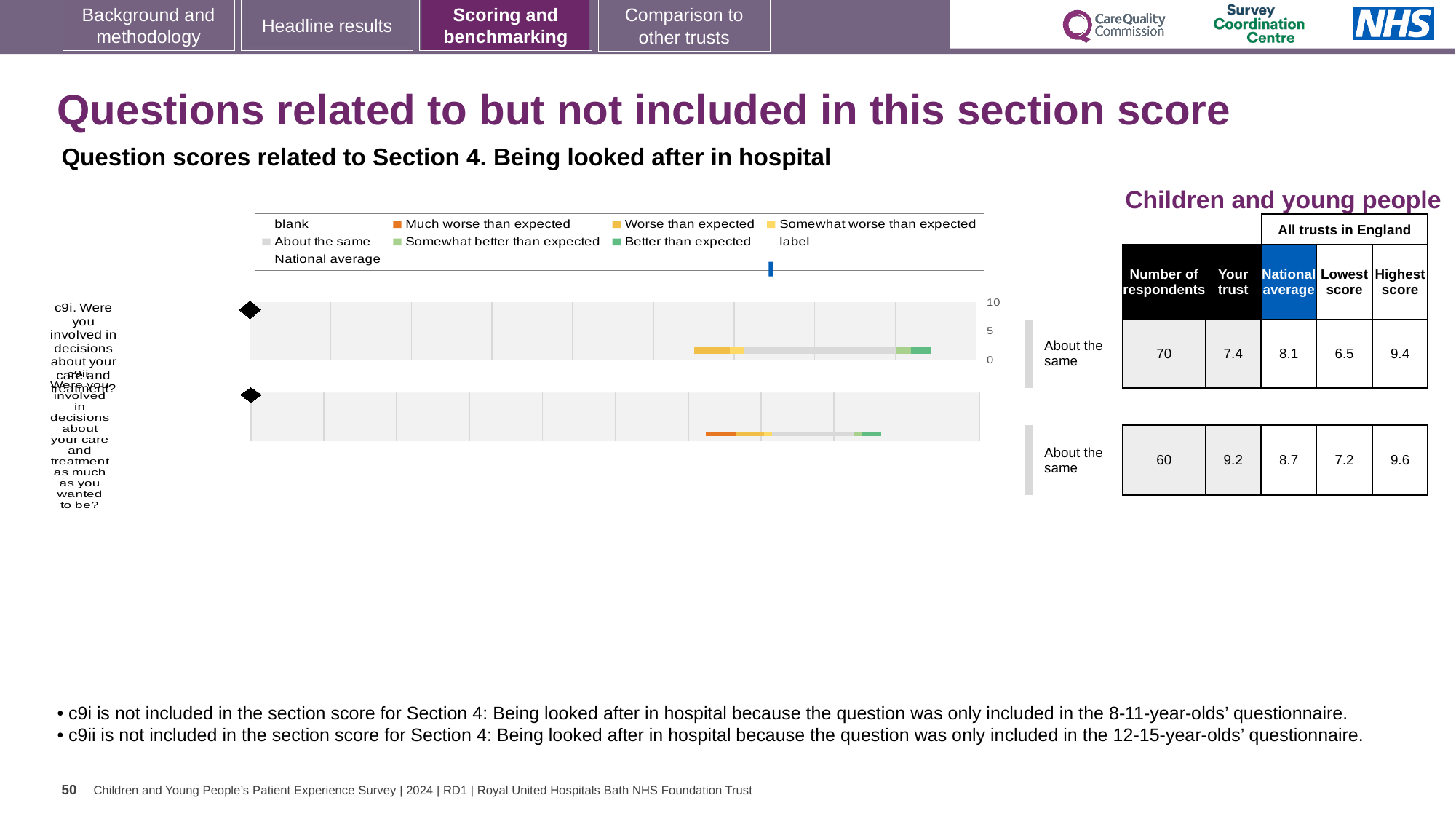
What benchmark category is shown for question c9ii? About the same What is the difference between the highest and lowest score for question c9i? 2.9 What kind of chart is used to show the question scores for c9i and c9ii? bar chart What is the 'Your trust' score for question c9i? 7.4 Which question has the higher 'Your trust' score, c9i or c9ii? c9ii What is the lowest score among all trusts in England for question c9ii? 7.2 What is the national average score for question c9ii? 8.7 How many questions are plotted in the chart? 2 In the chart legend, what colour represents 'Much worse than expected'? orange How many respondents answered question c9i? 70 Which question has the higher national average score? c9ii Is the 'Your trust' score for question c9i greater or less than 5? greater